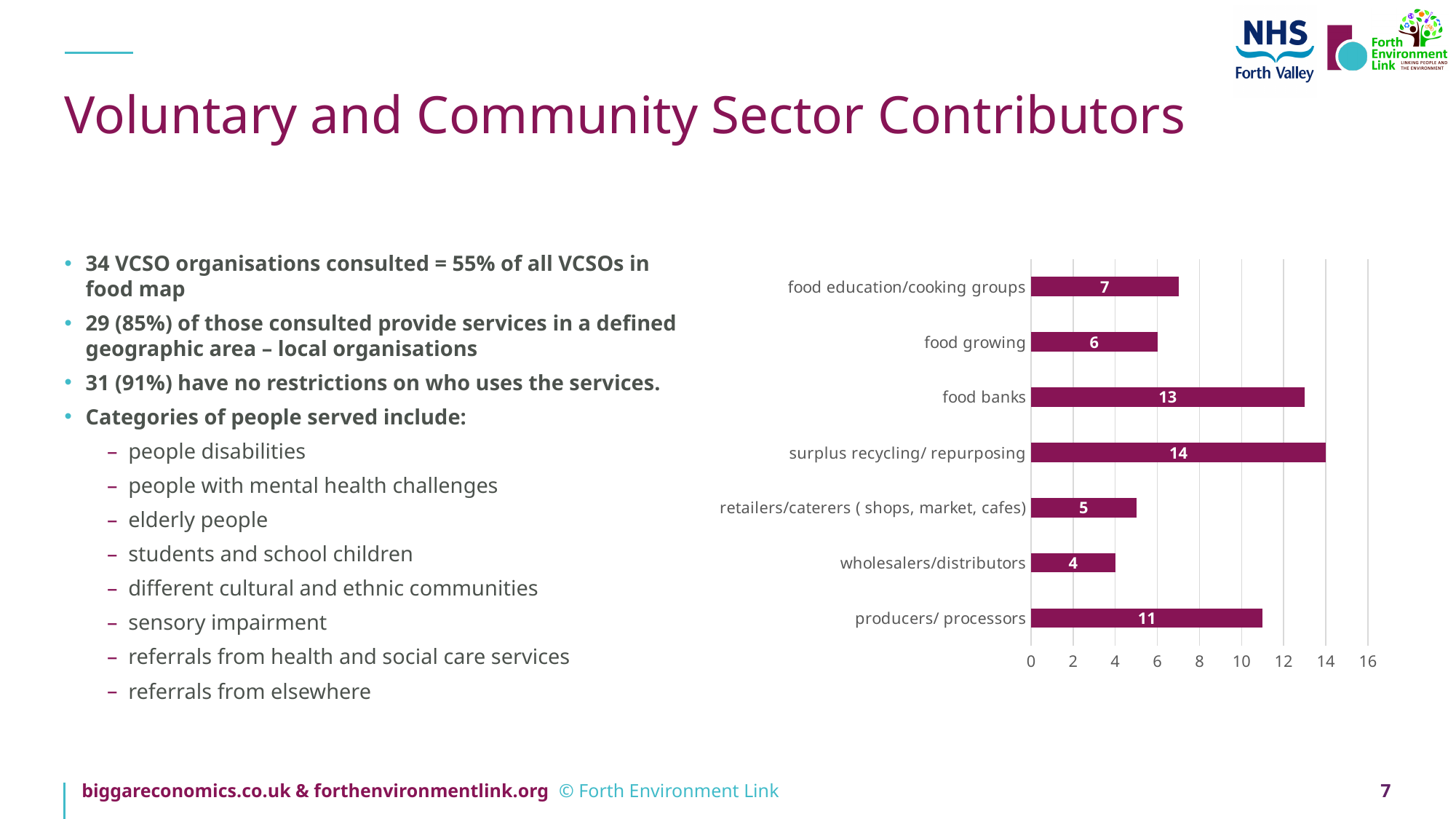
What kind of chart is shown on the slide? bar chart What is the value for food banks? 13 What is the maximum value shown on the chart's horizontal axis? 16 What is the value for surplus recycling/ repurposing? 14 How many categories are shown in the chart? 7 What is the value for producers/ processors? 11 What is the difference between the values for food banks and food growing? 7 Is the value for producers/ processors greater or less than 10? greater Which category has the highest value? surplus recycling/ repurposing Which is larger, the value for food education/cooking groups or the value for retailers/caterers ( shops, market, cafes)? food education/cooking groups Which category has the lowest value? wholesalers/distributors What is the value for wholesalers/distributors? 4